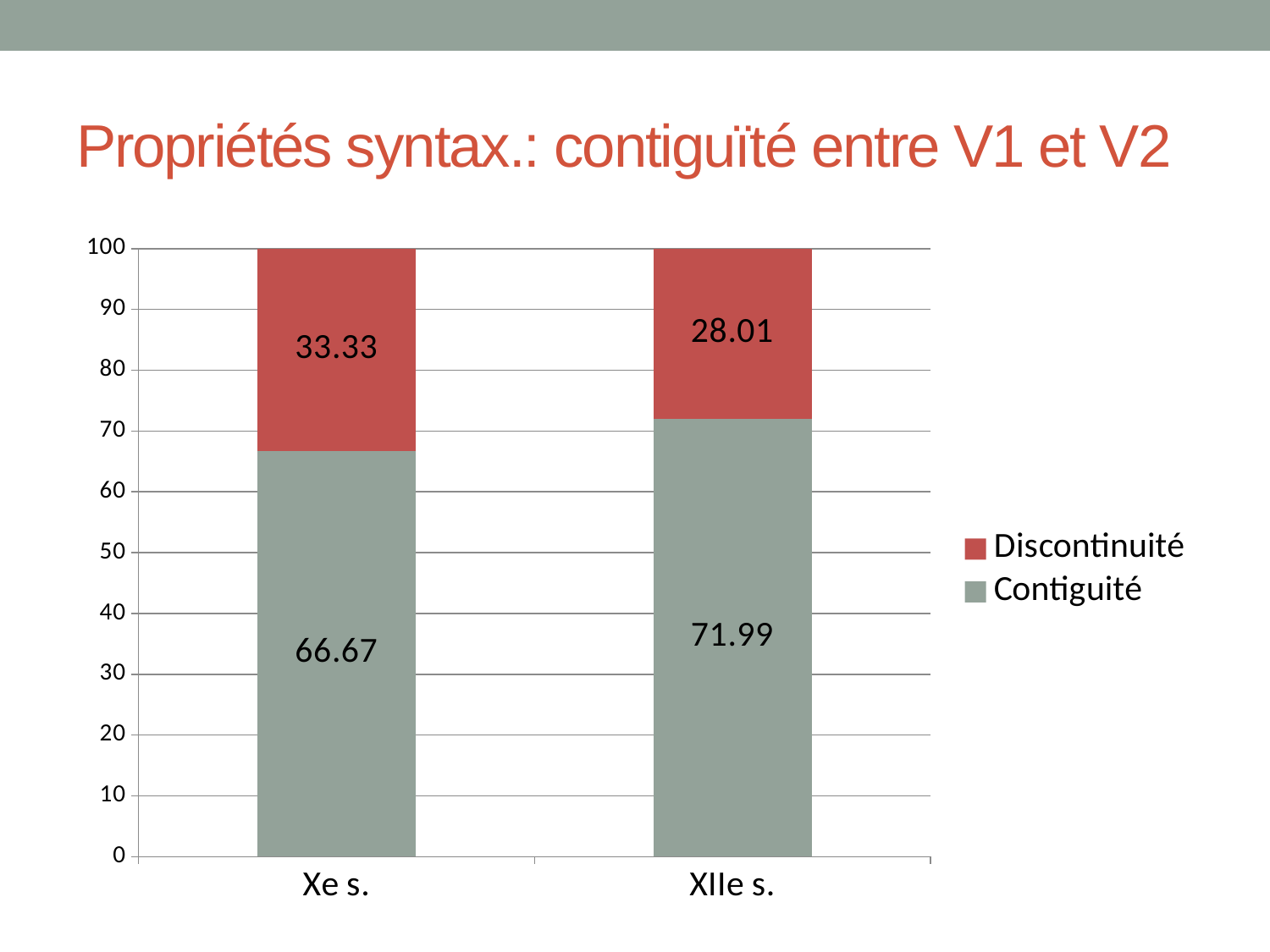
Does the Discontinuité value rise or fall from Xe s. to XIIe s.? Fall What is the total of the stacked bar for Xe s.? 100 Which category has the higher Contiguité value, Xe s. or XIIe s.? XIIe s. What kind of chart is shown on the slide? Stacked bar chart What is the Contiguité value for Xe s.? 66.67 What is the Contiguité value for XIIe s.? 71.99 What is the difference between the Contiguité values for XIIe s. and Xe s.? 5.32 How many series does the legend list? 2 What is the Discontinuité value for XIIe s.? 28.01 What is the Discontinuité value for Xe s.? 33.33 How many categories are shown on the x axis? 2 Which category has the lowest Discontinuité value? XIIe s.